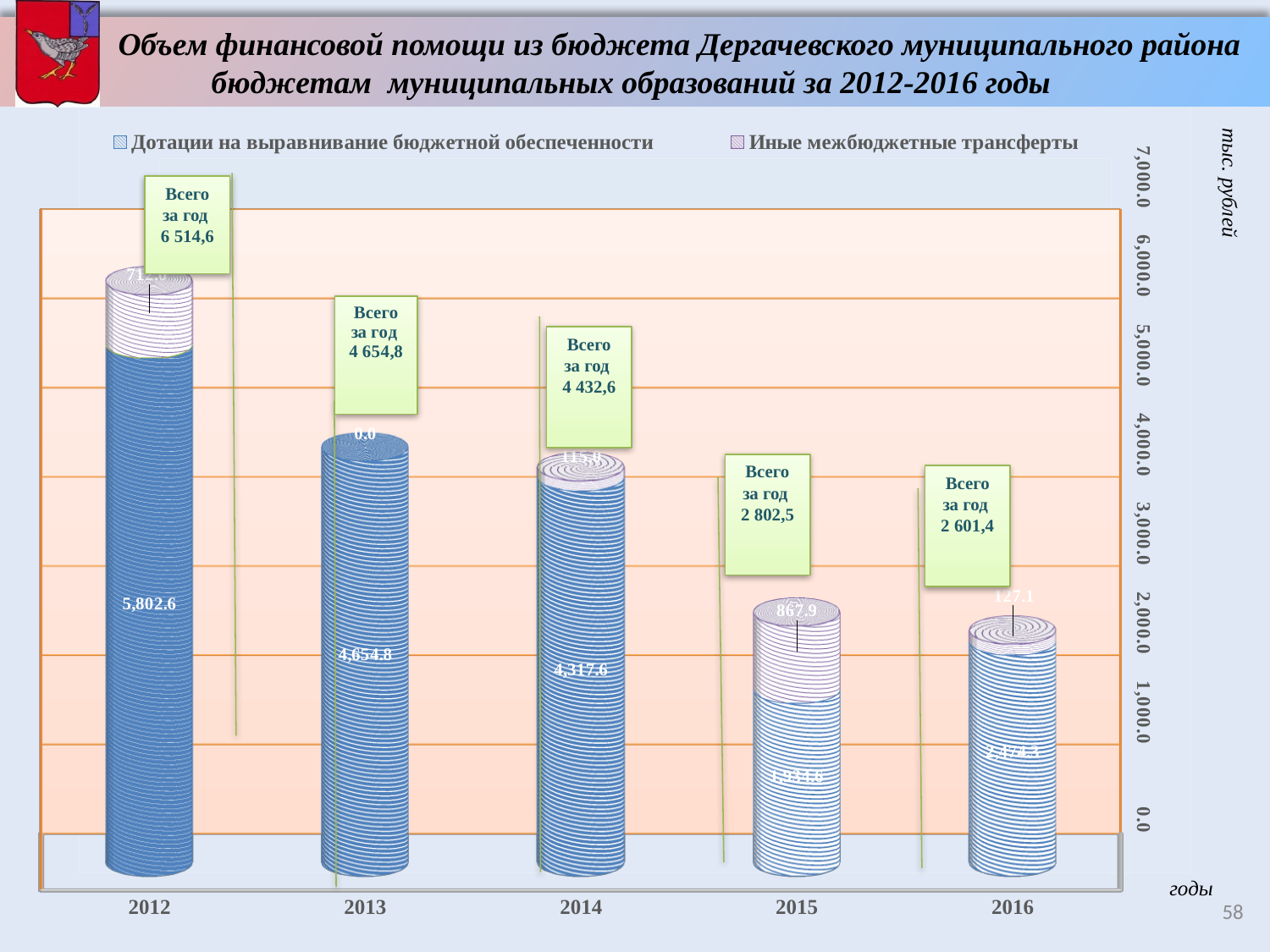
What is the total (Всего за год) for 2012? 6 514,6 Do the yearly totals rise or fall from 2012 to 2016? fall What is the value of Дотации на выравнивание бюджетной обеспеченности for 2013? 4,654.8 What is the value of Иные межбюджетные трансферты for 2015? 867.9 What is the value of Дотации на выравнивание бюджетной обеспеченности for 2012? 5,802.6 What is the value of Иные межбюджетные трансферты for 2013? 0.0 Which year has the highest total financial assistance? 2012 What is the difference between the Дотации values for 2012 and 2013? 1,147.8 What is the total (Всего за год) for 2015? 2 802,5 How many series does the legend list? 2 What kind of chart is shown on the slide? bar chart How many years are shown on the x axis? 5